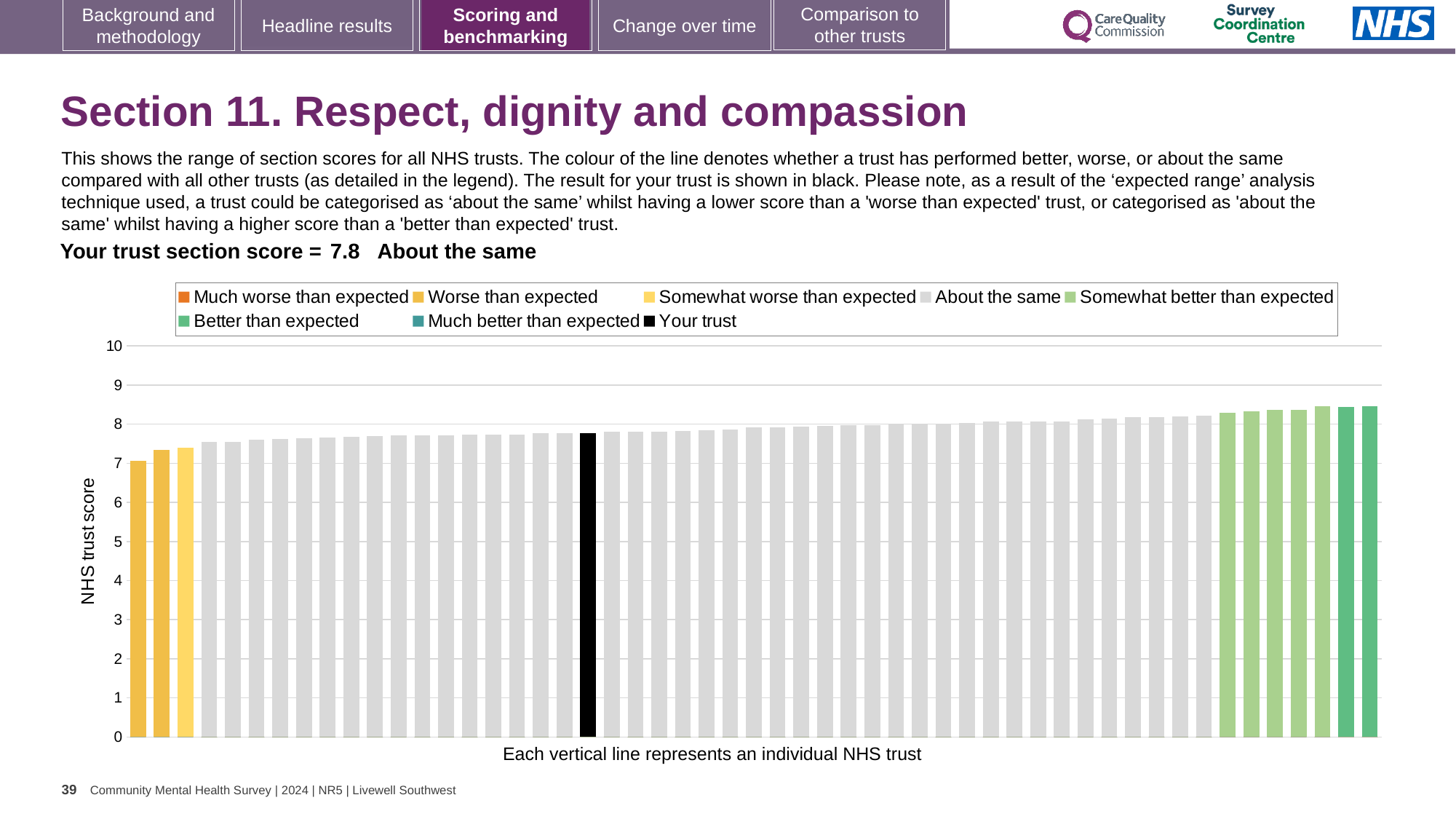
Do the bar values rise or fall from left to right along the x axis? rise Is the value of the highest bar greater or less than 9? less What colour is the bar representing your trust? black Which is larger, the leftmost bar or the rightmost bar? the rightmost bar Is the value of the leftmost (lowest) bar greater or less than 8? less Which is larger, your trust's score or the leftmost bar? your trust's score How many entries does the chart legend list? 8 What is your trust's section score for Section 11, Respect, dignity and compassion? 7.8 What is the label on the vertical axis of the chart? NHS trust score Is the value of the rightmost (highest) bar greater or less than 8? greater How is your trust categorised compared with other trusts in Section 11? About the same What type of chart is shown on the slide? bar chart